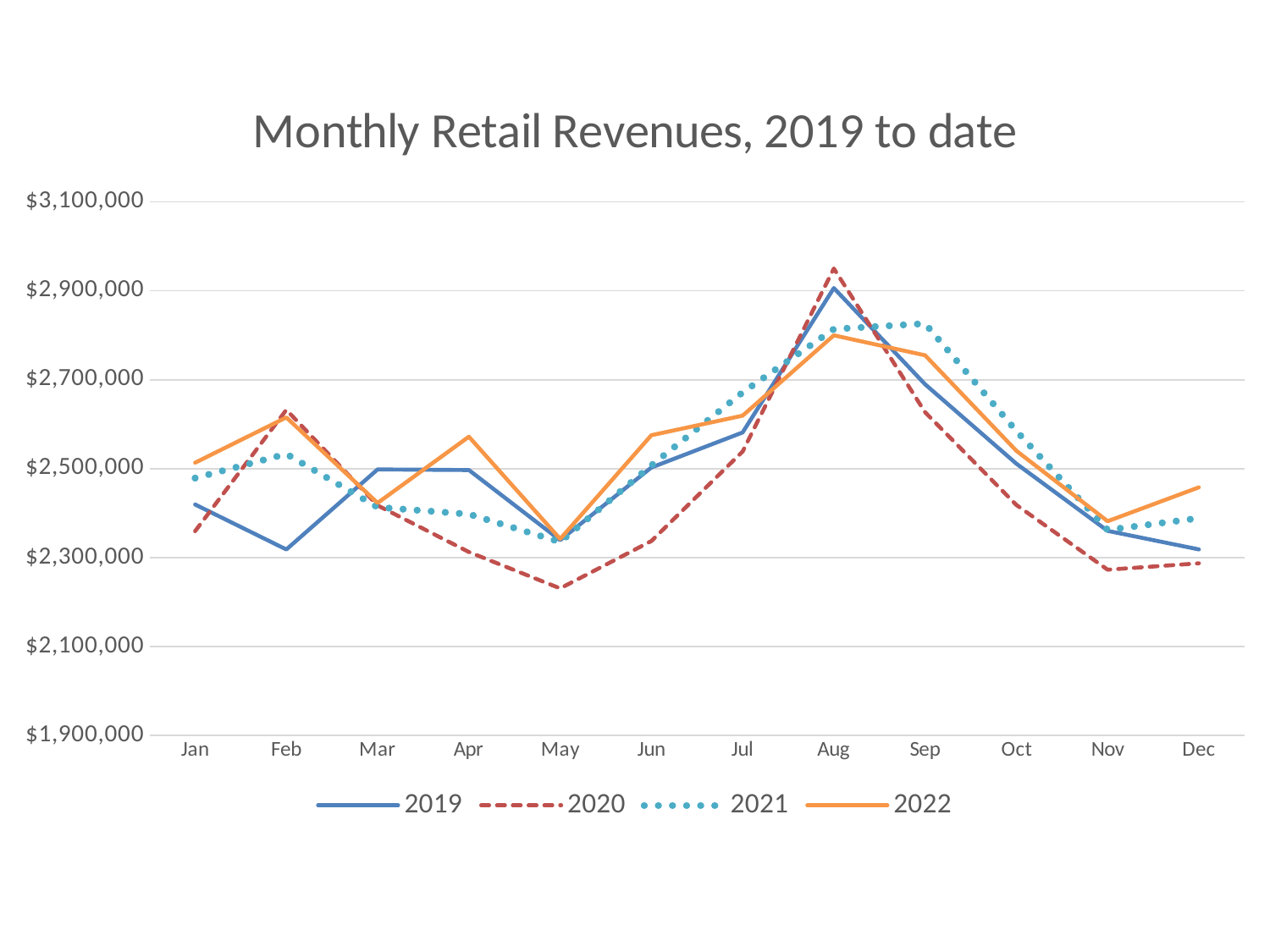
What is the title of the chart? Monthly Retail Revenues, 2019 to date In which month does the 2020 series reach its highest value? Aug What kind of chart is shown on the slide? Line chart Is the value for 2021 in Sep greater or less than $2,700,000? greater Is the value for 2020 in Aug greater or less than $2,900,000? greater How many series does the legend list? 4 How many months are plotted along the x axis? 12 In which month does the 2020 series reach its lowest value? May Does the 2020 series rise or fall from Aug to Nov? Fall Is the value for 2020 in May greater or less than $2,300,000? less In Feb, which series has the larger value, 2019 or 2020? 2020 In which month does the 2019 series reach its highest value? Aug